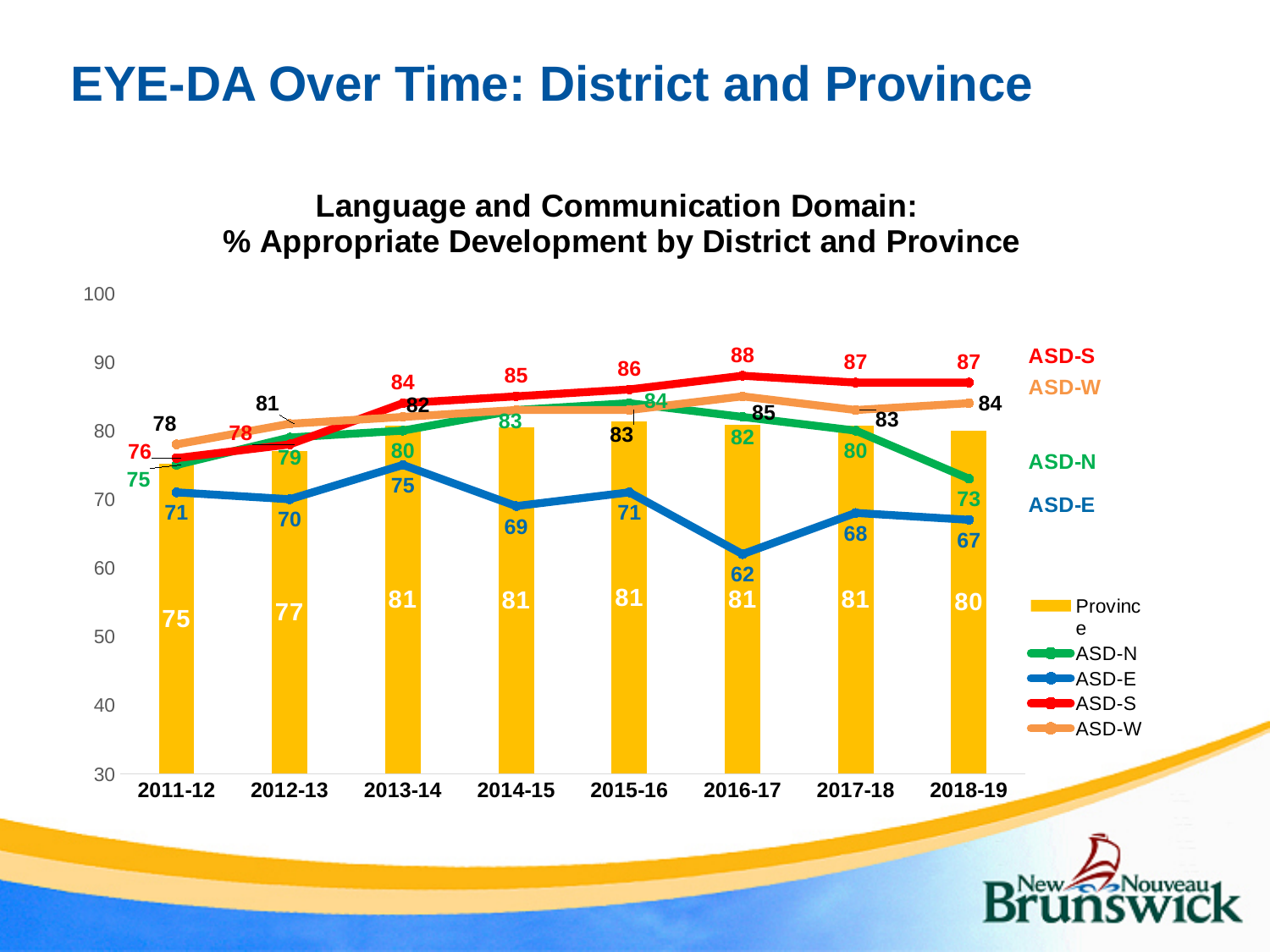
How many school years are shown on the x axis? 8 What kind of chart is this? Combined bar and line chart In which year is the ASD-S value highest? 2016-17 In 2018-19, which is larger: ASD-N or ASD-E? ASD-N In which year is the ASD-E value lowest? 2016-17 What is the ASD-S value for 2016-17? 88 Does the ASD-S value rise or fall from 2011-12 to 2016-17? Rise How many series does the legend list? 5 What is the difference between the ASD-S and ASD-E values in 2016-17? 26 What is the Province value for 2012-13? 77 What is the ASD-E value for 2016-17? 62 What is the ASD-W value for 2018-19? 84